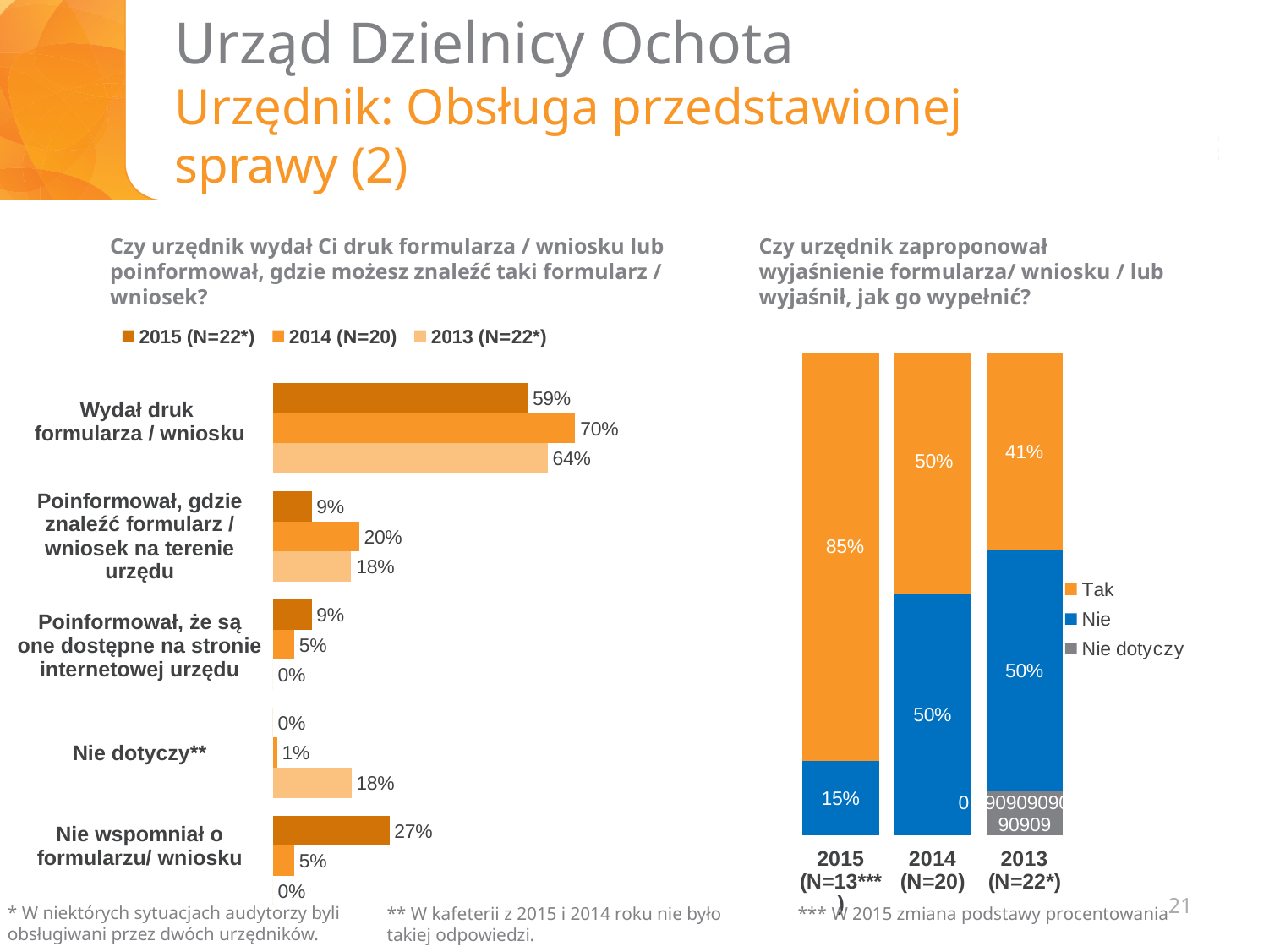
In the left chart, what is the value for 'Nie dotyczy**' in the 2013 (N=22*) series? 18% In the right chart, which year has the highest 'Tak' share? 2015 How many series does the legend of the left chart list? 3 In the right chart, what is the 'Nie' share for 2013 (N=22*)? 50% In the right chart, what is the 'Tak' share for 2015 (N=13***)? 85% In the left chart, what is the difference between the 2014 and 2015 values for 'Wydał druk formularza / wniosku'? 11% In the left chart, which category has the highest value in the 2015 (N=22*) series? Wydał druk formularza / wniosku How many categories are shown in the left chart? 5 In the left chart, which is larger for 'Poinformował, gdzie znaleźć formularz / wniosek na terenie urzędu': the 2014 value or the 2013 value? 2014 In the left chart, what is the value for 'Nie wspomniał o formularzu/ wniosku' in the 2015 (N=22*) series? 27% What kind of chart is the left chart? Bar chart In the left chart, what is the value for 'Wydał druk formularza / wniosku' in the 2014 (N=20) series? 70%